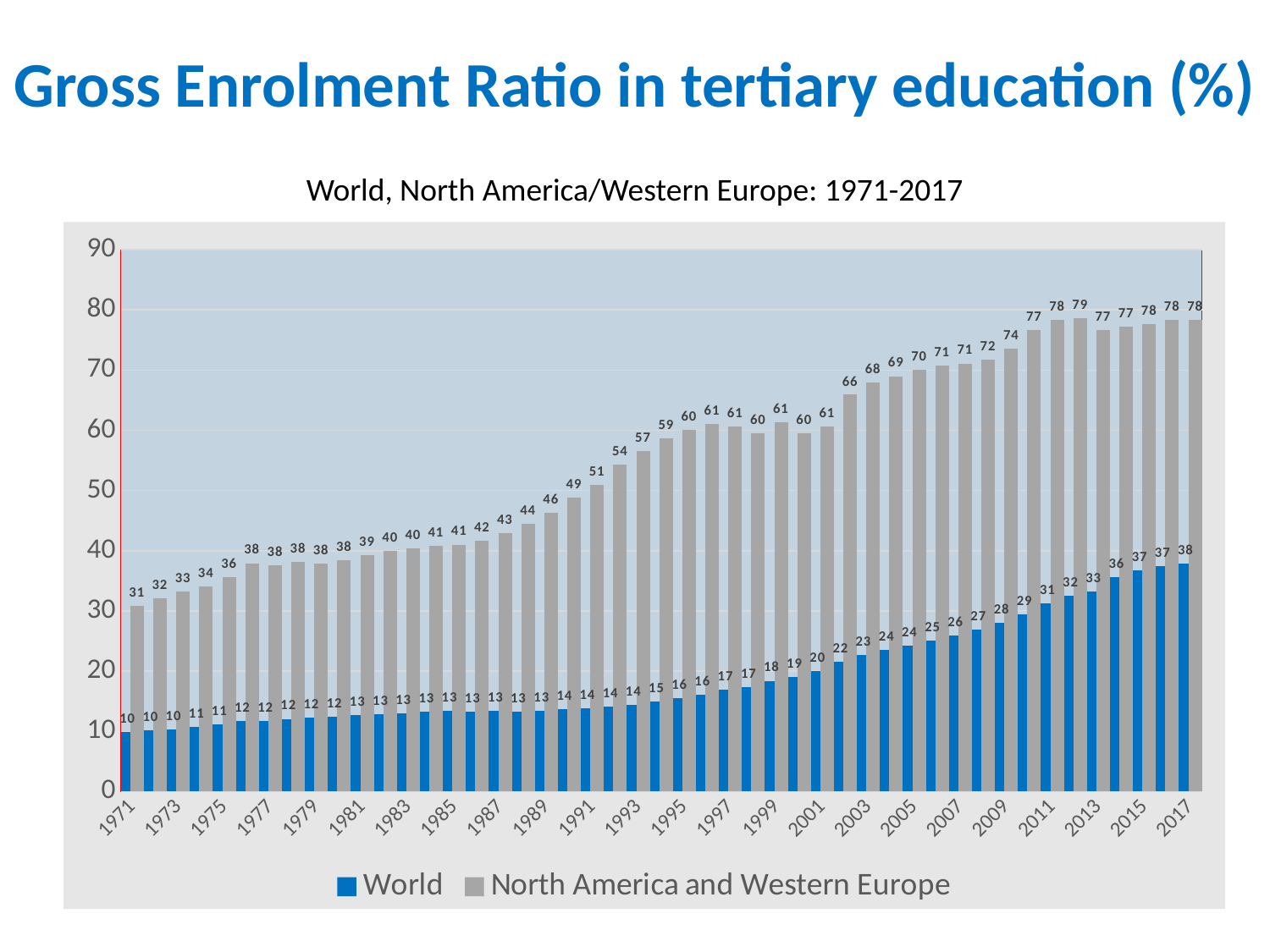
What is the difference between the North America and Western Europe value and the World value in 2017? 40 What kind of chart is shown? Bar chart Which is larger: the World value in 2017 or the North America and Western Europe value in 1971? World value in 2017 In which year is the World series at its highest? 2017 What is the value for North America and Western Europe in 1991? 51 What is the value for North America and Western Europe in 1971? 31 What is the World value for 2017? 38 Does the World series rise or fall from 1971 to 2017? Rise What is the lowest value shown for the World series? 10 What is the highest value shown for North America and Western Europe? 79 What is the World value for 2001? 20 How many series does the legend list? 2